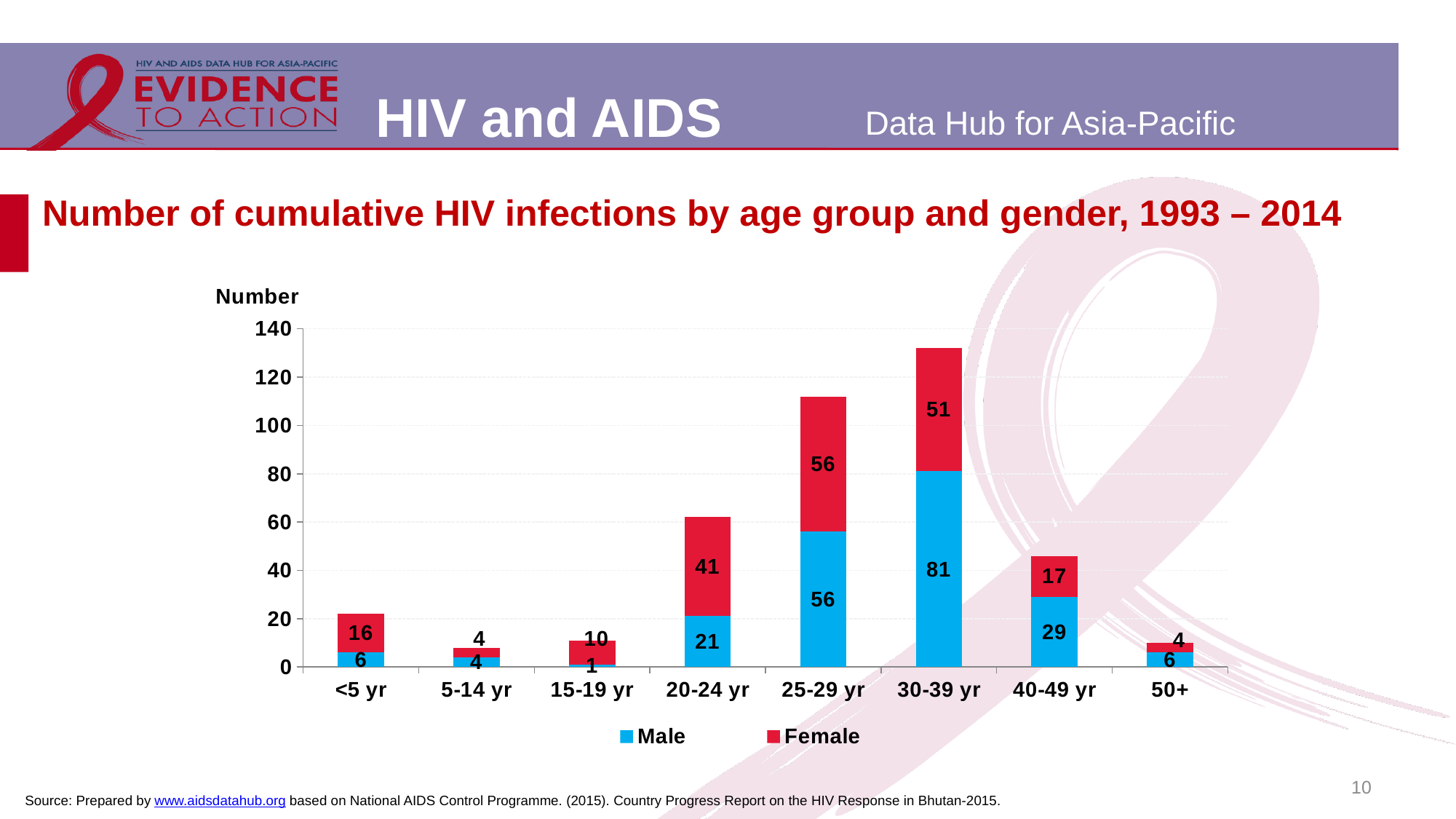
What is the Female value for the 20-24 yr age group? 41 What is the Male value for the 15-19 yr age group? 1 What is the Male value for the 30-39 yr age group? 81 Which age group has the highest Male value? 30-39 yr What is the total of the stacked bar for the 25-29 yr age group? 112 Which age group has the lowest Male value? 15-19 yr What type of chart is shown on the slide? Stacked bar chart What is the difference between the Female and Male values for the <5 yr age group? 10 Which is larger for the 40-49 yr age group, the Male value or the Female value? Male What is the total of the stacked bar for the 30-39 yr age group? 132 How many series does the legend list? 2 How many age groups are shown on the x axis? 8